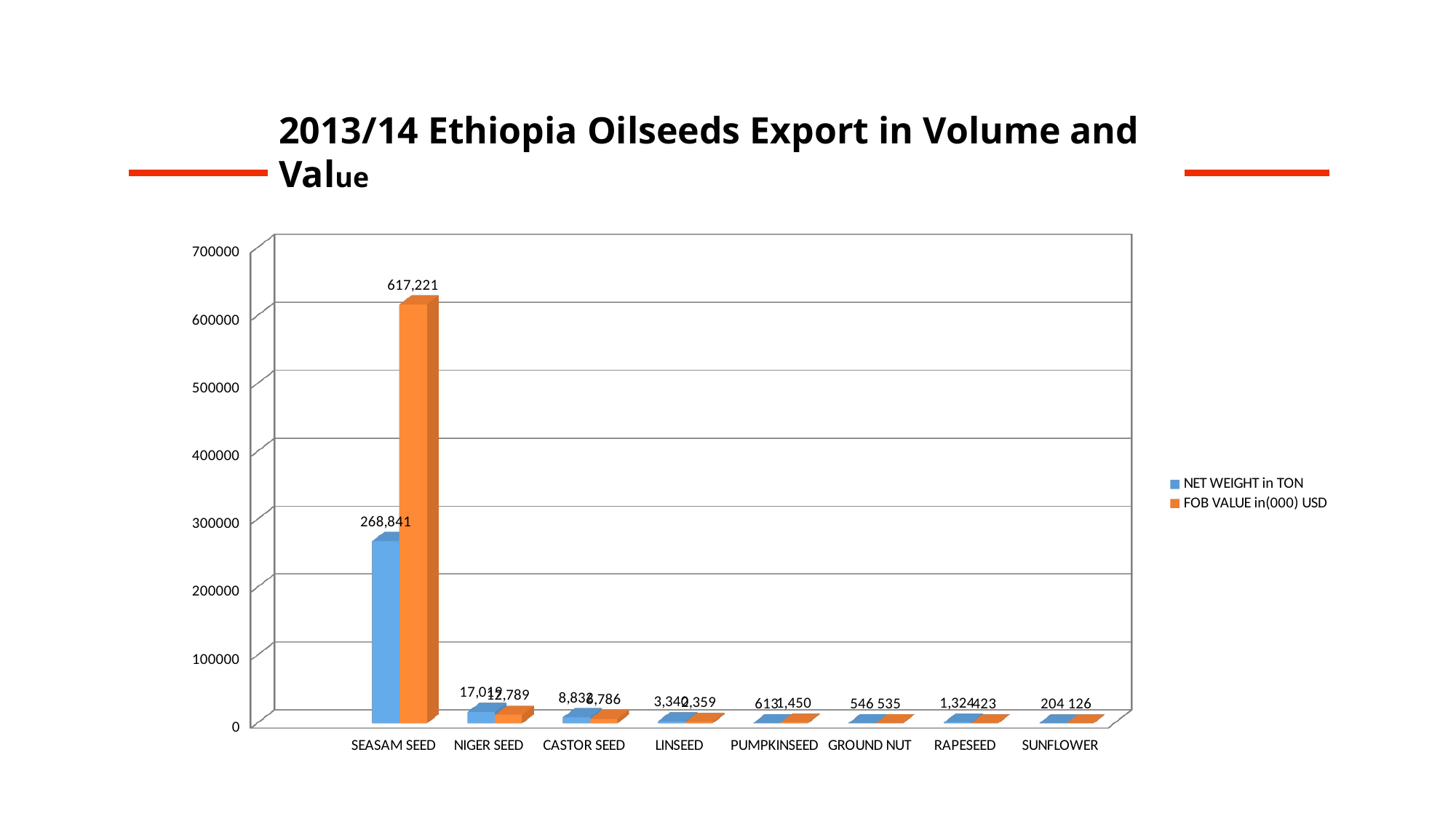
What is the FOB VALUE in(000) USD for GROUND NUT? 535 How many series does the legend list? 2 What is the difference between the NET WEIGHT in TON and the FOB VALUE in(000) USD for SUNFLOWER? 78 For SUNFLOWER, which is larger: the NET WEIGHT in TON or the FOB VALUE in(000) USD? NET WEIGHT in TON What is the difference between the FOB VALUE in(000) USD and the NET WEIGHT in TON for SEASAM SEED? 348,380 Is the FOB VALUE in(000) USD for SEASAM SEED greater or less than 600000? greater What is the FOB VALUE in(000) USD for SEASAM SEED? 617,221 Which category has the highest FOB VALUE in(000) USD? SEASAM SEED What kind of chart is shown on the slide? Bar chart What is the NET WEIGHT in TON for SEASAM SEED? 268,841 How many oilseed categories are shown on the x axis? 8 What is the NET WEIGHT in TON for SUNFLOWER? 204